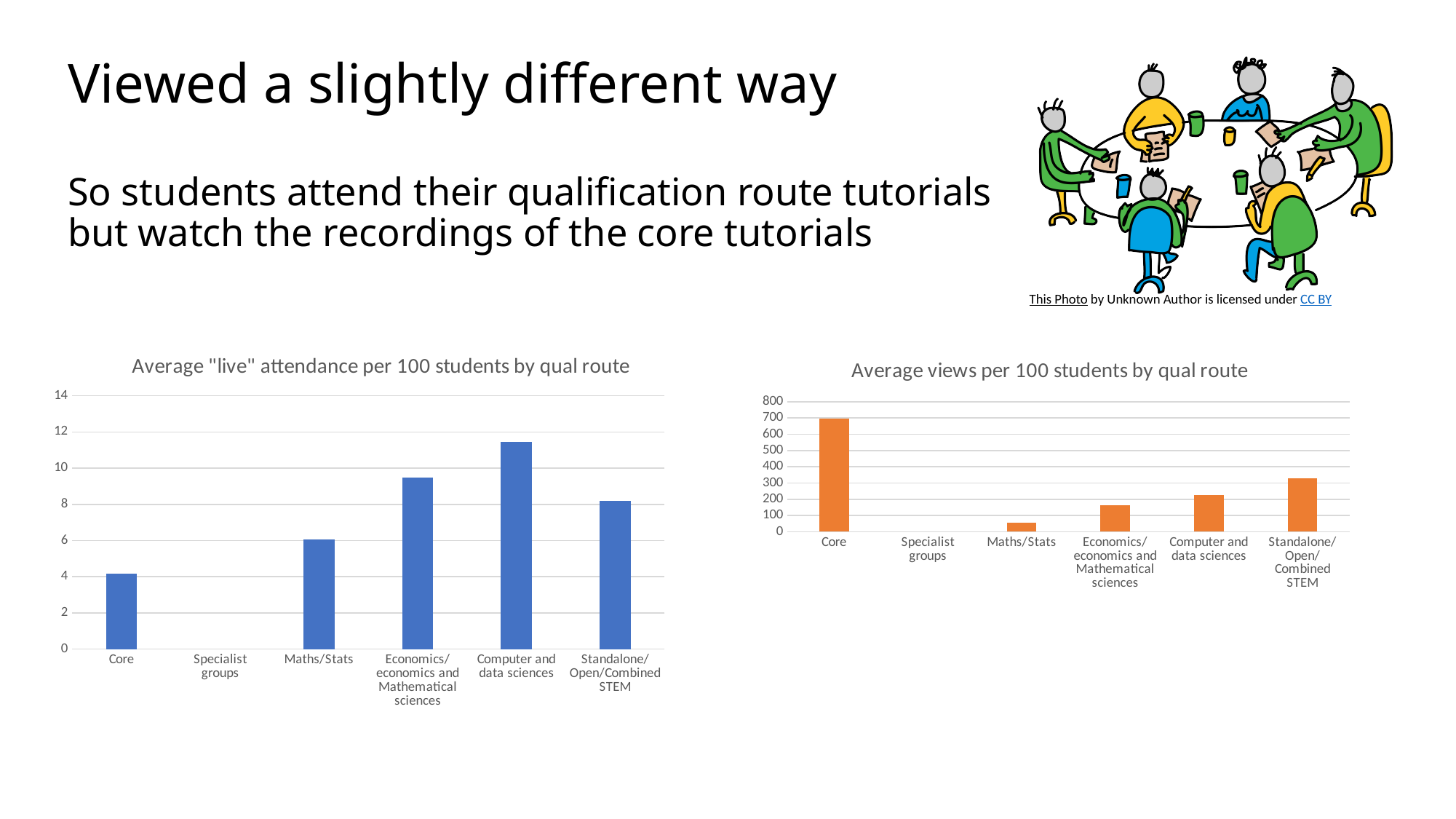
In the "Average views per 100 students by qual route" chart, which category has the highest value? Core In the "Average views per 100 students by qual route" chart, is the value for Core greater or less than 600? greater In the "Average views per 100 students by qual route" chart, which is larger: Economics/economics and Mathematical sciences or Computer and data sciences? Computer and data sciences In the "Average "live" attendance per 100 students by qual route" chart, which category has the highest value? Computer and data sciences In the "Average views per 100 students by qual route" chart, is the value for Standalone/Open/Combined STEM greater or less than 300? greater In the "Average "live" attendance per 100 students by qual route" chart, is the value for Computer and data sciences greater or less than 10? greater What colour are the bars in the "Average views per 100 students by qual route" chart? orange How many categories are shown on the x axis of the "Average views per 100 students by qual route" chart? 6 What kind of chart is the "Average "live" attendance per 100 students by qual route" chart? bar chart In the "Average "live" attendance per 100 students by qual route" chart, which is larger: Maths/Stats or Standalone/Open/Combined STEM? Standalone/Open/Combined STEM